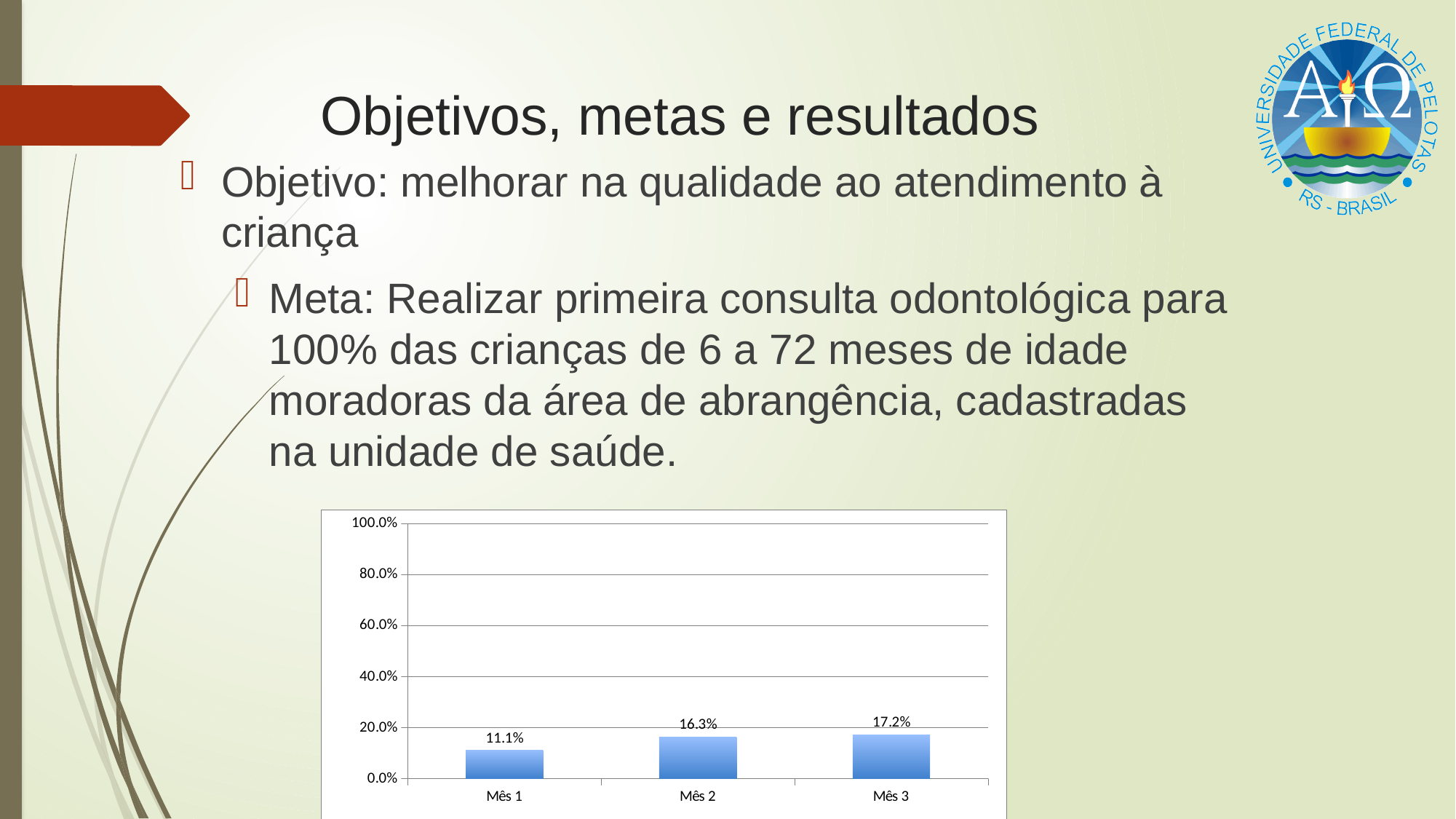
Which is larger, the value for Mês 1 or the value for Mês 2? Mês 2 How many months are shown on the x axis? 3 What is the value for Mês 1? 11.1% What is the value for Mês 3? 17.2% What is the difference between the values for Mês 3 and Mês 1? 6.1% Do the values rise or fall from Mês 1 to Mês 3? rise Which month has the lowest value? Mês 1 What is the value for Mês 2? 16.3% Which month has the highest value? Mês 3 What kind of chart is shown on the slide? bar chart Is the value for Mês 3 greater or less than 20.0%? less What is the difference between the values for Mês 2 and Mês 1? 5.2%